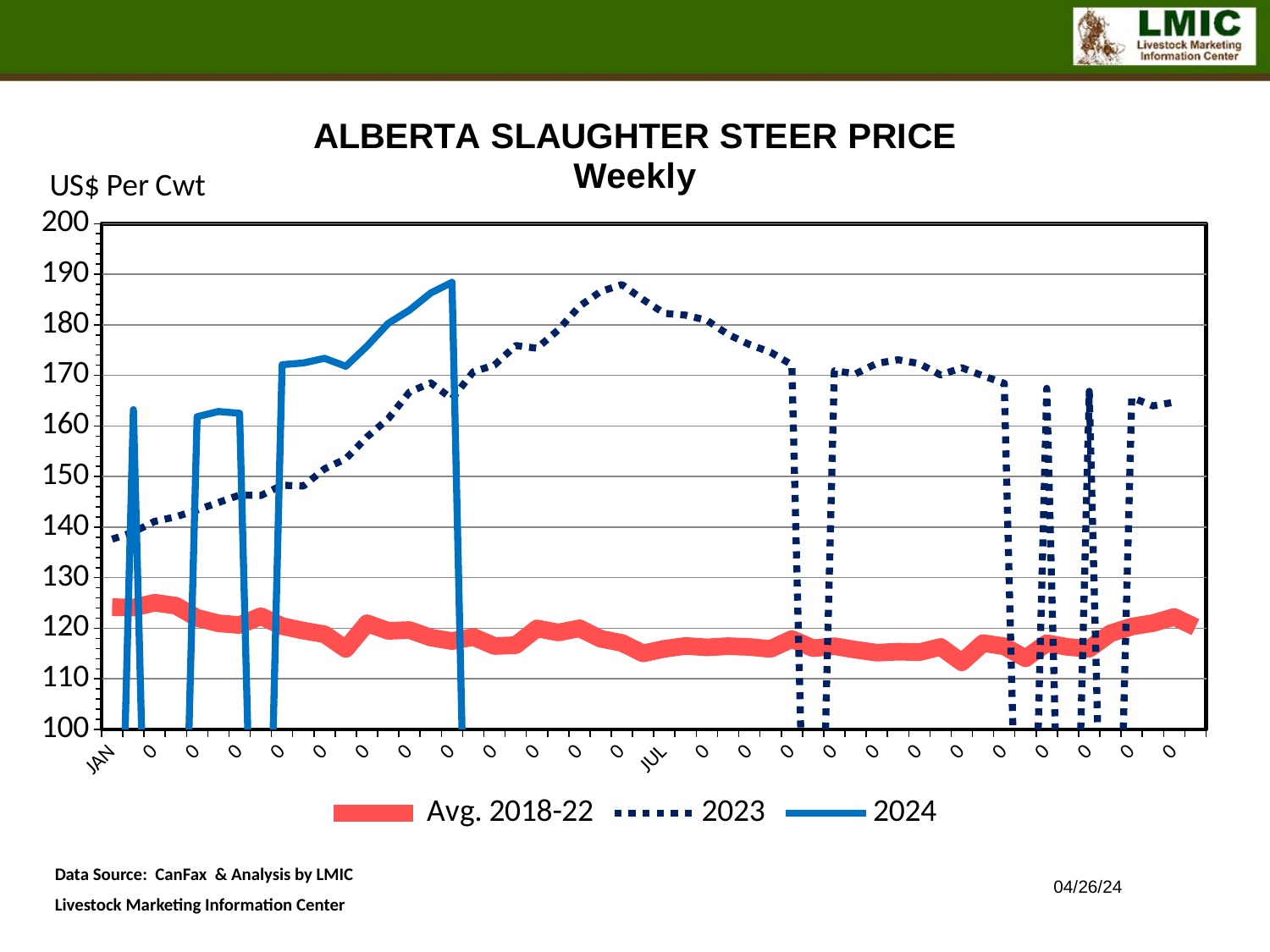
What kind of chart is shown on the slide? line chart What is the title of the chart? ALBERTA SLAUGHTER STEER PRICE Does the Avg. 2018-22 line generally rise or fall from JAN to JUL? fall At JUL, which series is higher, 2023 or Avg. 2018-22? 2023 How many series does the legend list? 3 At JAN, which series is higher, 2023 or Avg. 2018-22? 2023 Is the value of the 2023 line at JAN greater or less than 130? greater Is the lowest value of the Avg. 2018-22 line greater or less than 120? less Is the highest value of the 2023 line greater or less than 180? greater What unit is shown on the vertical axis label? US$ Per Cwt